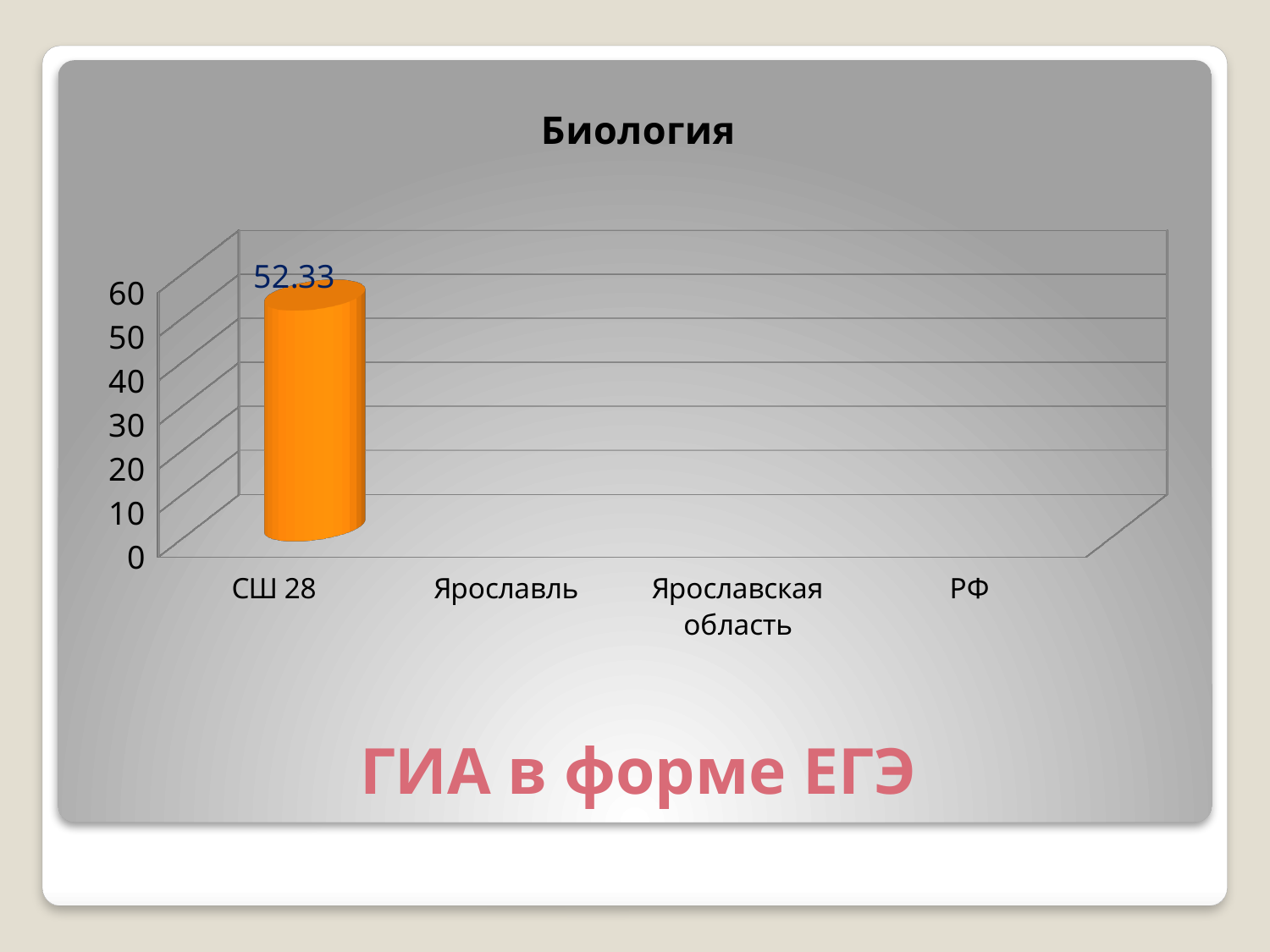
Is the value for СШ 28 greater or less than 50? greater Is the value for СШ 28 greater or less than 60? less What is the value for СШ 28 in the Биология chart? 52.33 What is the highest tick value shown on the vertical axis? 60 What type of chart is shown on the slide? bar chart Which category has the highest value in the chart? СШ 28 What colour is the bar for СШ 28? orange Which category is listed last on the x axis? РФ What is the title of the chart? Биология How many categories are listed on the x axis of the chart? 4 How many categories have a bar plotted in the chart? 1